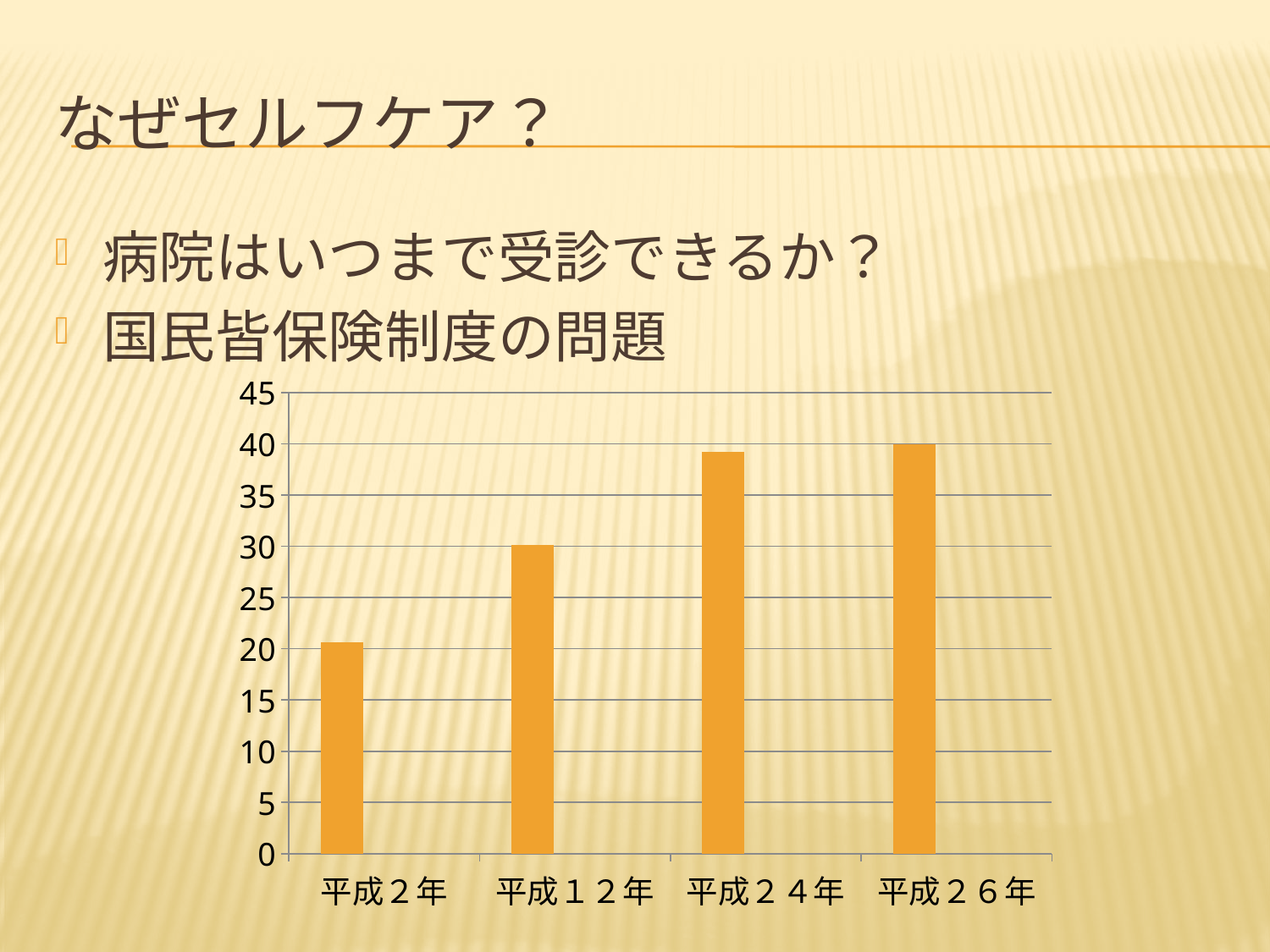
Which is larger, the value for 平成１２年 or the value for 平成２４年? 平成２４年 Is the value for 平成２６年 greater or less than 35? greater What kind of chart is shown on the slide? bar chart Is the value for 平成１２年 greater or less than 35? less How many categories are shown on the x axis of the chart? 4 Do the values rise or fall from 平成２年 to 平成２６年 along the x axis? rise Is the value for 平成１２年 greater or less than 25? greater Which is larger, the value for 平成２年 or the value for 平成１２年? 平成１２年 What is the highest value shown on the y axis of the chart? 45 Which category has the lowest value in the chart? 平成２年